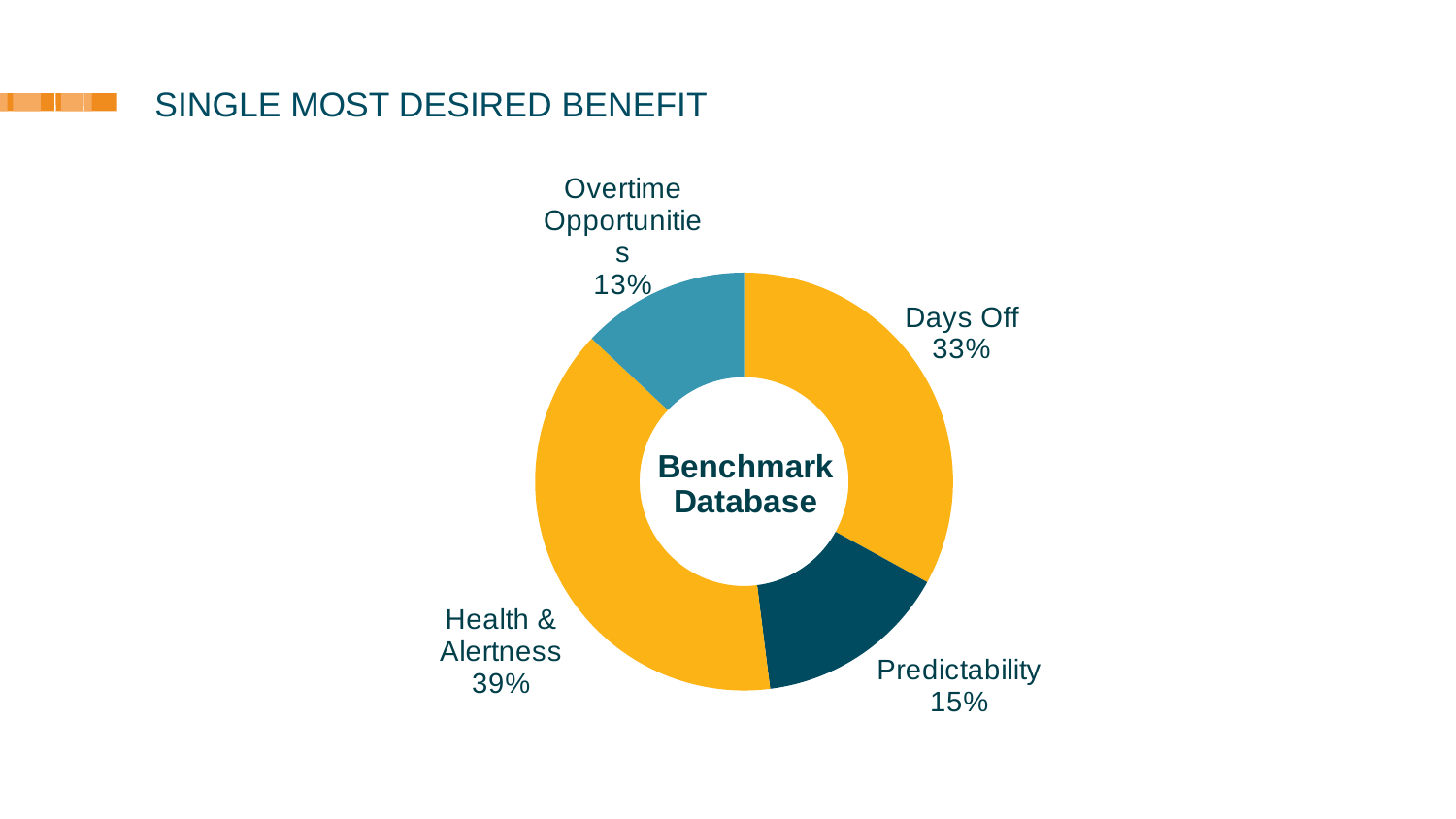
Which has a larger share, Days Off or Predictability? Days Off What text appears in the center of the donut chart? Benchmark Database What is the difference in percentage points between Health & Alertness and Days Off? 6 Which benefit has the smallest share of the chart? Overtime Opportunities What percentage is shown for Predictability? 15% How many benefit categories are shown in the chart? 4 What kind of chart is shown on the slide? Pie chart (donut) What percentage is shown for Days Off? 33% What percentage of respondents chose Health & Alertness as the single most desired benefit? 39% What percentage is shown for Overtime Opportunities? 13% Which benefit has the largest share of the chart? Health & Alertness What is the difference in percentage points between Predictability and Overtime Opportunities? 2